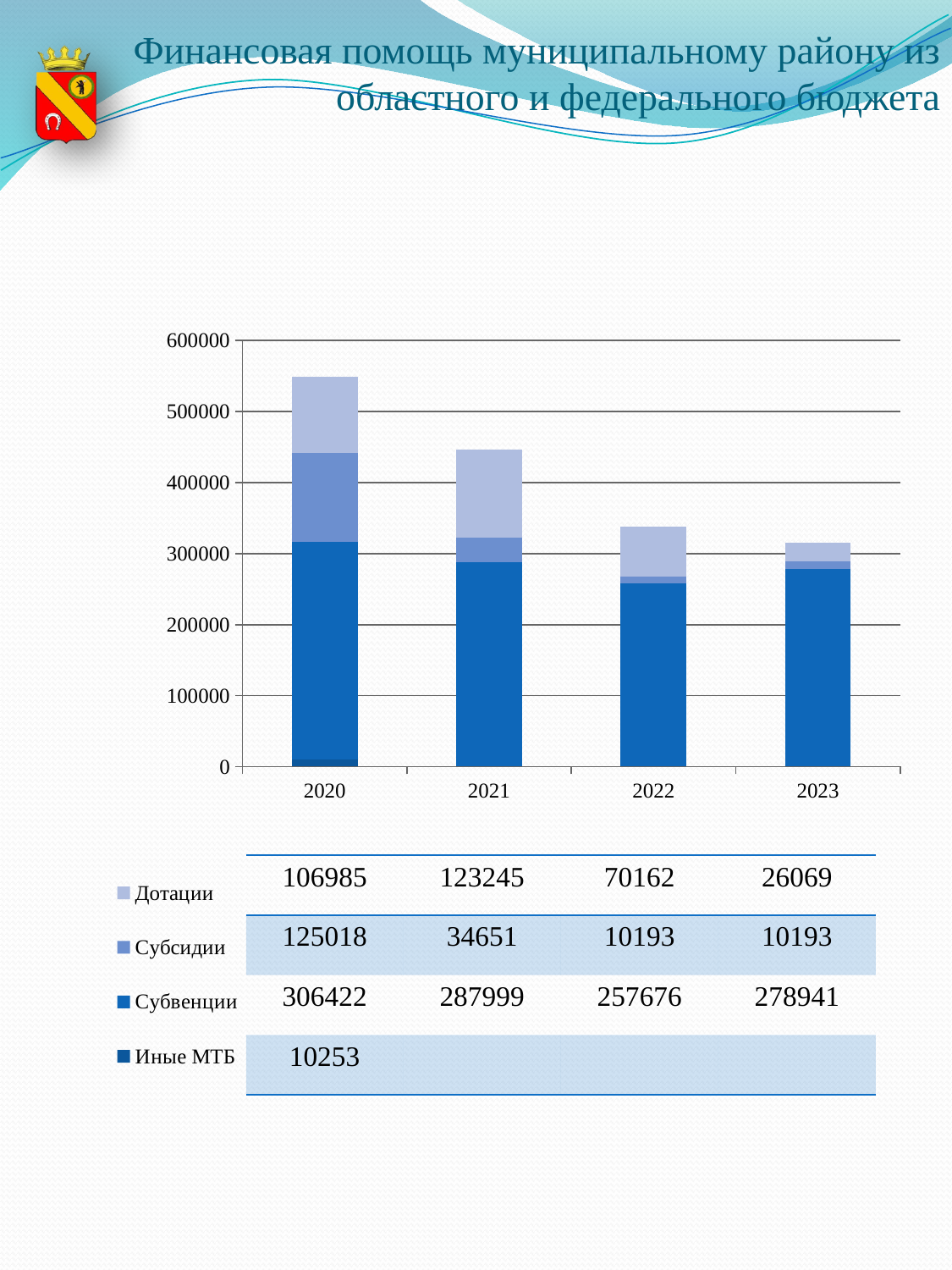
What is the value of Иные МТБ for 2020? 10253 What kind of chart is shown on the slide? stacked bar chart What is the total of the stacked bar for 2021? 445895 In which year is the value of Субвенции the lowest? 2022 Which is larger for 2020: Дотации or Субсидии? Субсидии How many years are shown on the x axis? 4 What is the difference between the Субвенции values for 2020 and 2021? 18423 What is the value of Субвенции for 2022? 257676 In which year is the value of Дотации the highest? 2021 How many series does the legend list? 4 Is the total height of the stacked bar for 2020 greater or less than 500000? greater What is the value of Дотации for 2021? 123245